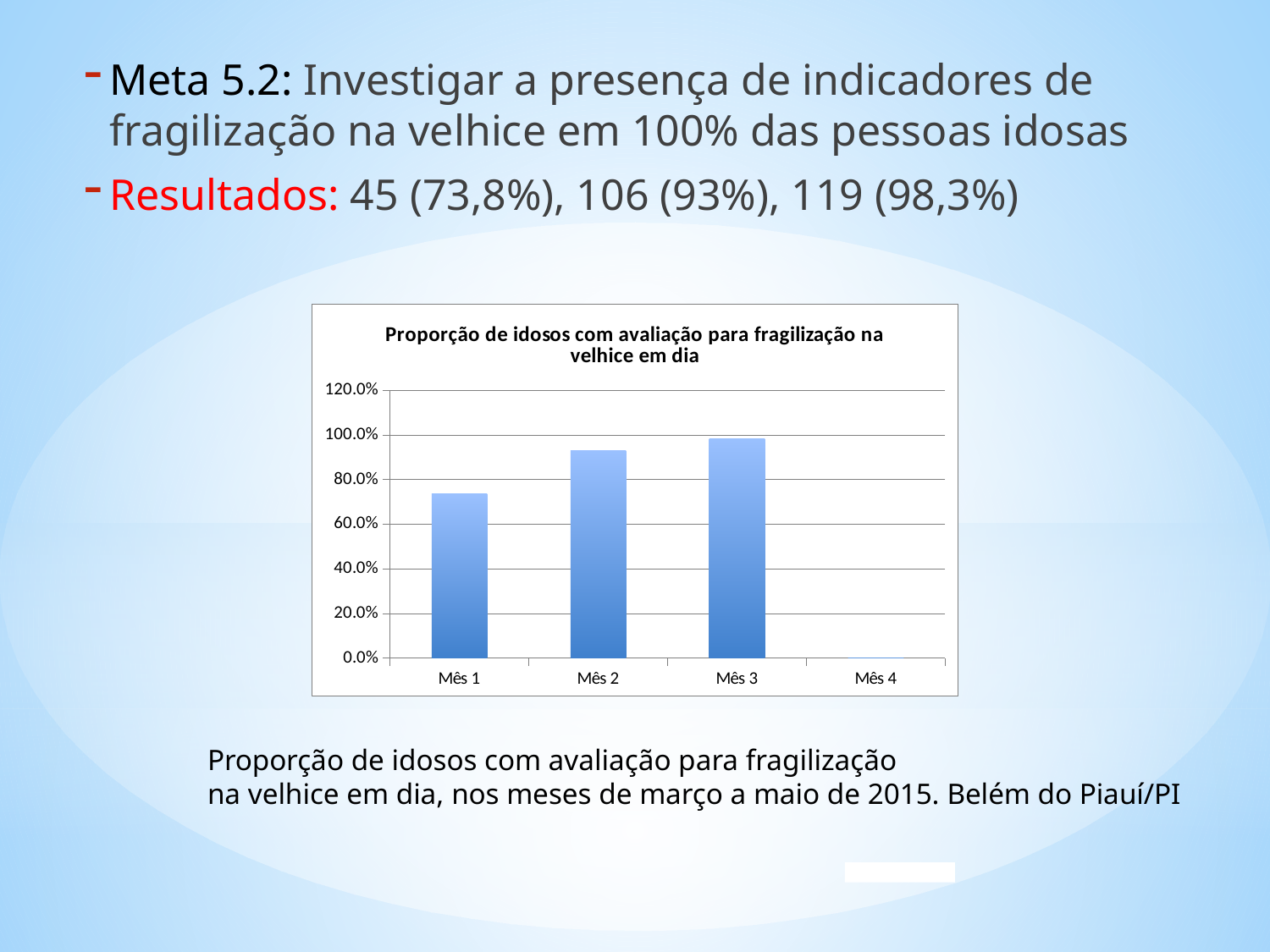
What kind of chart is shown on the slide? bar chart What is the title of the chart? Proporção de idosos com avaliação para fragilização na velhice em dia Is the value for Mês 3 greater or less than 100.0%? less Is the value for Mês 1 greater or less than 80.0%? less Which month has the highest bar in the chart? Mês 3 Which is larger, the value for Mês 1 or the value for Mês 2? Mês 2 Among the months with a plotted bar, which has the lowest value? Mês 1 Do the values rise or fall from Mês 1 to Mês 3? rise Is the value for Mês 1 greater or less than 60.0%? greater How many categories are shown on the x axis of the chart? 4 How many bars are plotted in the chart? 3